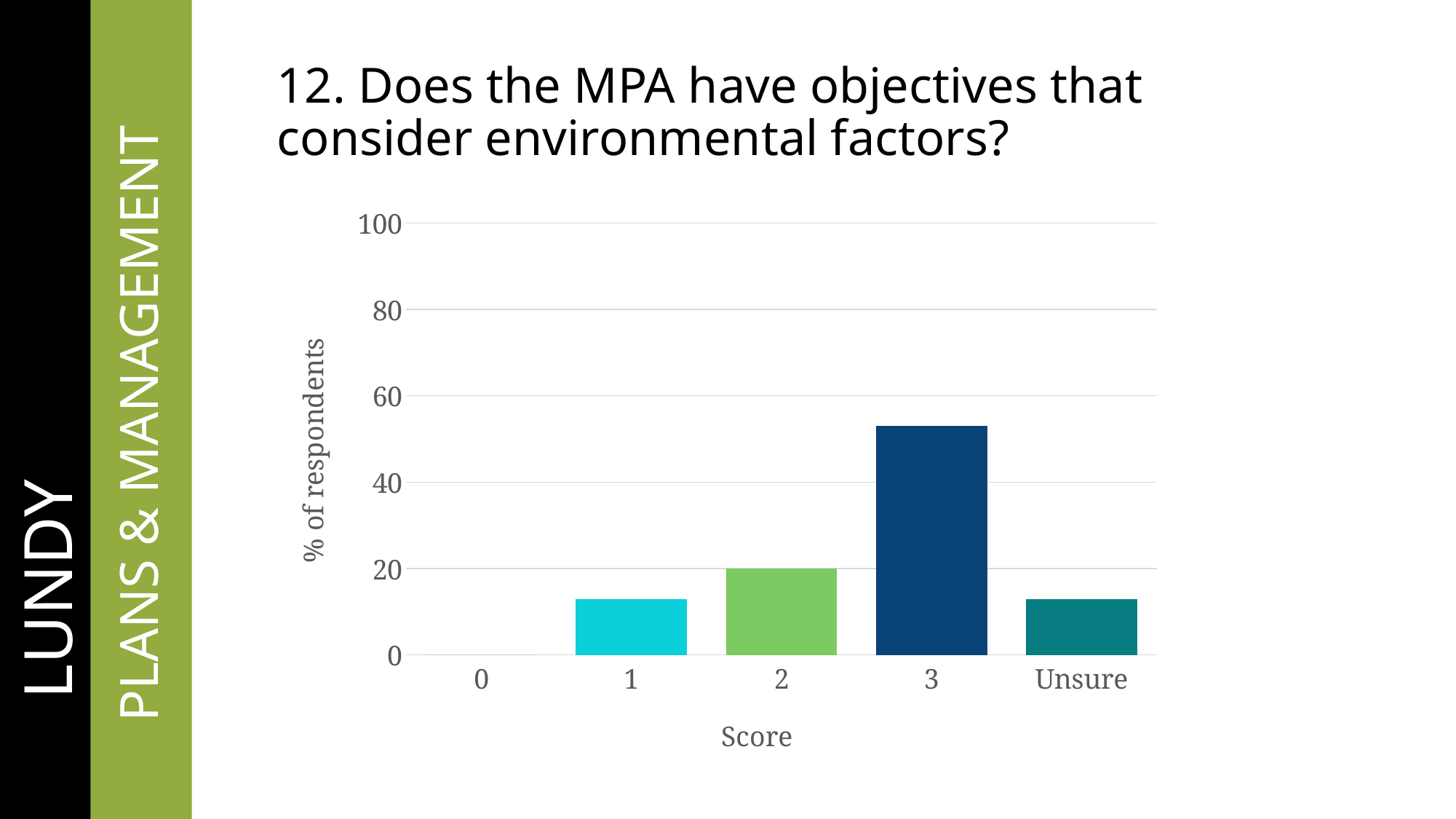
Is the value for score 3 greater or less than 60? less Which score category has the highest percentage of respondents? 3 Is the value for score 3 greater or less than 40? greater Which has a higher percentage of respondents, score 3 or score 2? 3 How many score categories are shown on the x axis? 5 Is the value for score 1 greater or less than 20? less What kind of chart is shown on the slide? bar chart Which has a higher percentage of respondents, score 2 or score 1? 2 What is the label of the y axis? % of respondents Which score category has the lowest percentage of respondents? 0 What is the percentage of respondents for score 2? 20